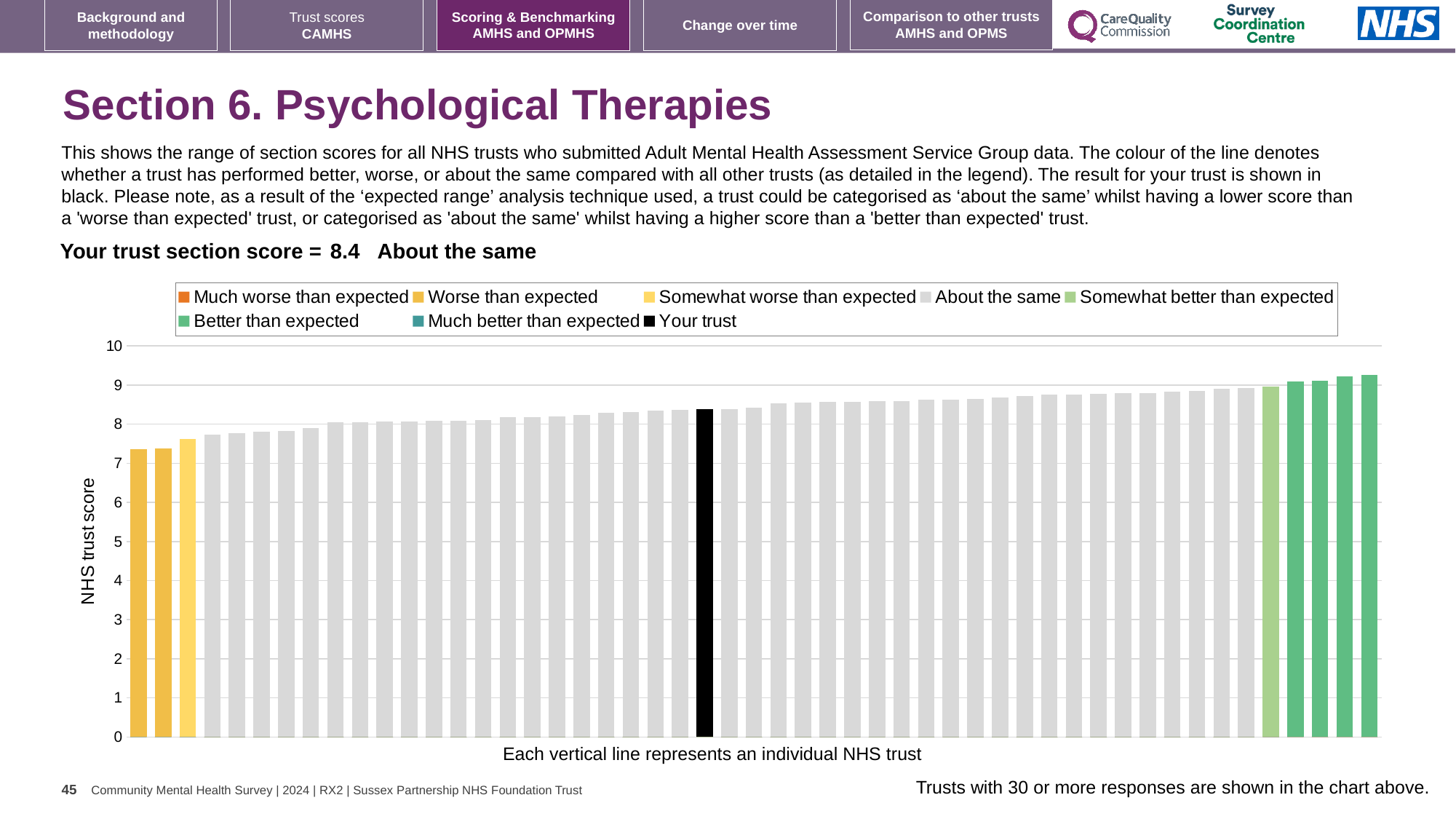
Which category is your trust placed in for this section? About the same How many entries does the chart legend list? 8 How many bars are coloured in the 'Worse than expected' yellow colour? 2 Is the value of the black 'Your trust' bar greater or less than 8? greater Do the bar values rise or fall from left to right along the x axis? rise What is the label on the y axis of the chart? NHS trust score Is the value of the leftmost bar in the chart greater or less than 8? less What kind of chart is shown on the slide? bar chart What is the section score for your trust shown on the slide? 8.4 Is the value of the tallest bar in the chart greater or less than 9? greater How many bars are coloured in the 'Better than expected' green colour? 4 What colour is used for the 'Your trust' bar in the chart? black